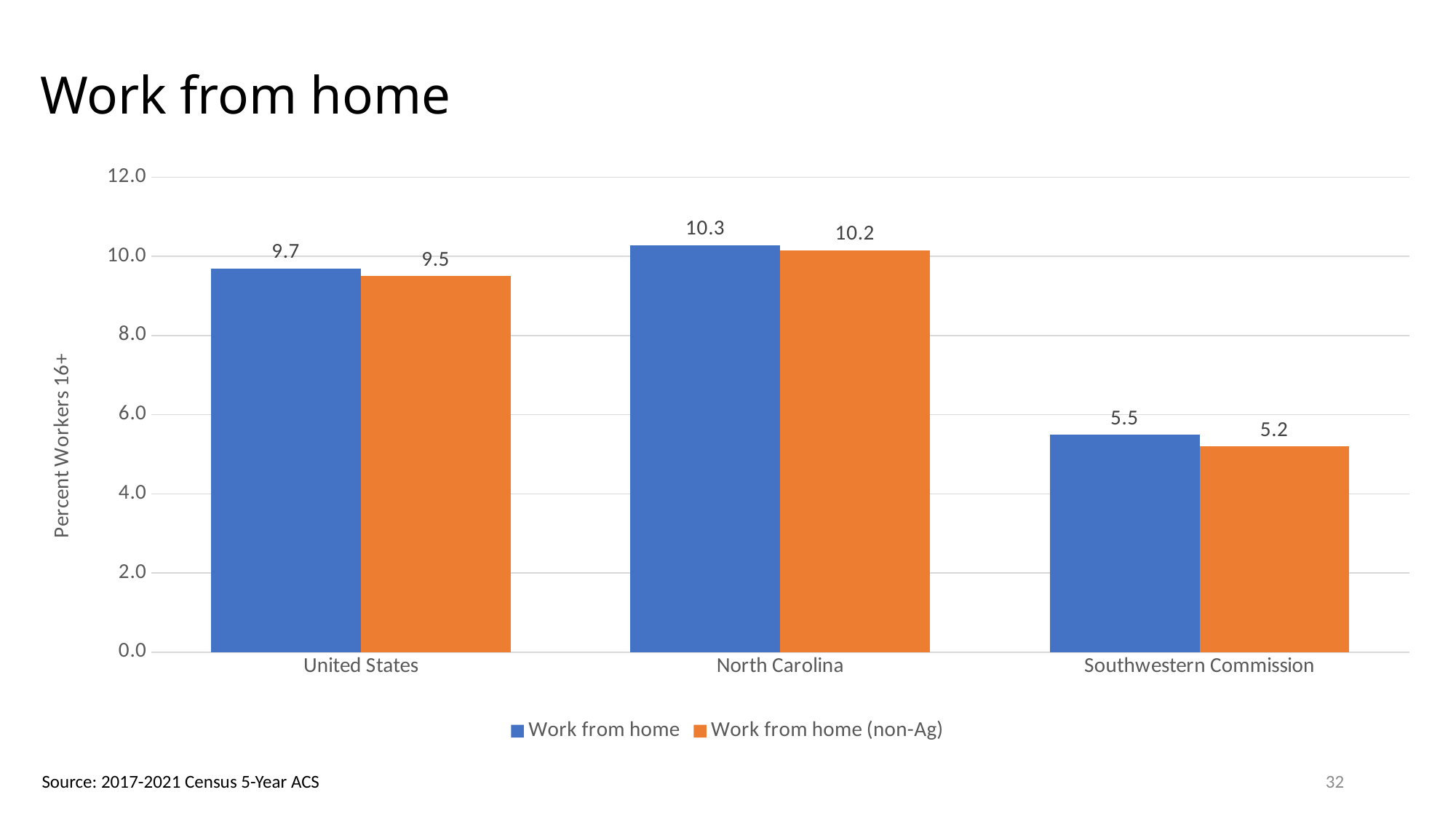
How many categories are shown on the x axis? 3 What is the difference between the Work from home values for North Carolina and Southwestern Commission? 4.8 What is the Work from home (non-Ag) value for Southwestern Commission? 5.2 What is the difference between the Work from home and Work from home (non-Ag) values for the United States? 0.2 What is the label of the y axis? Percent Workers 16+ What kind of chart is shown on the slide? Bar chart Which category has the highest Work from home value? North Carolina Which category has the lowest Work from home (non-Ag) value? Southwestern Commission What is the Work from home value for North Carolina? 10.3 Which is larger: the Work from home value for the United States or for Southwestern Commission? United States What is the Work from home (non-Ag) value for the United States? 9.5 How many series does the legend list? 2